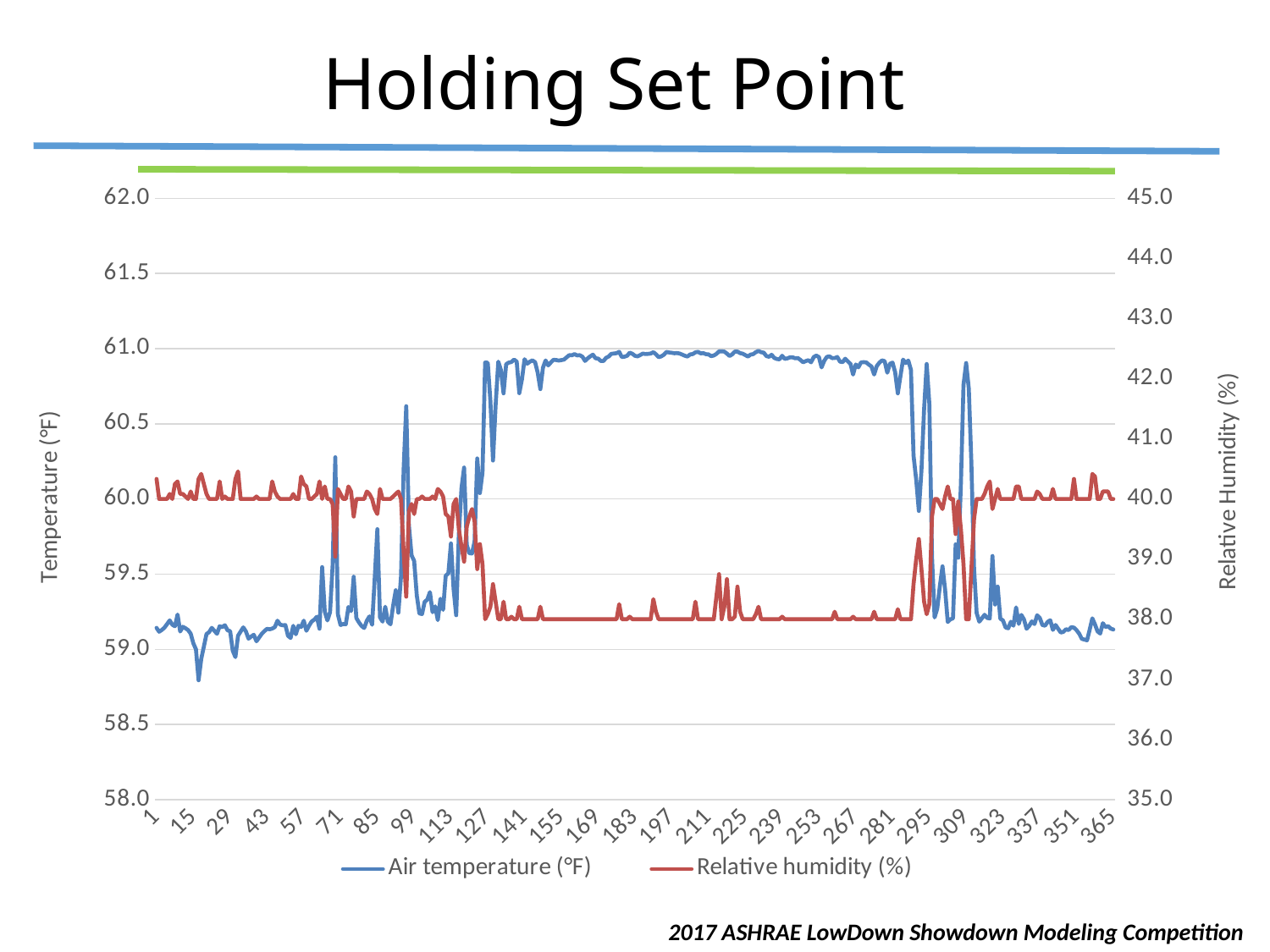
Is the Relative humidity (%) value at day 365 greater or less than 39.0? greater What kind of chart is shown on the slide? Line chart Is the Relative humidity (%) value at day 197 greater or less than 39.0? less Is the Air temperature (°F) value at day 1 greater or less than 59.5? less What is the title of the chart? Holding Set Point How many series does the legend list? 2 Does the Relative humidity (%) series rise or fall between day 113 and day 141? Fall Which is larger: the Relative humidity (%) at day 1 or at day 197? Day 1 Which series is drawn in red? Relative humidity (%) Which is larger: the Air temperature (°F) at day 197 or at day 365? Day 197